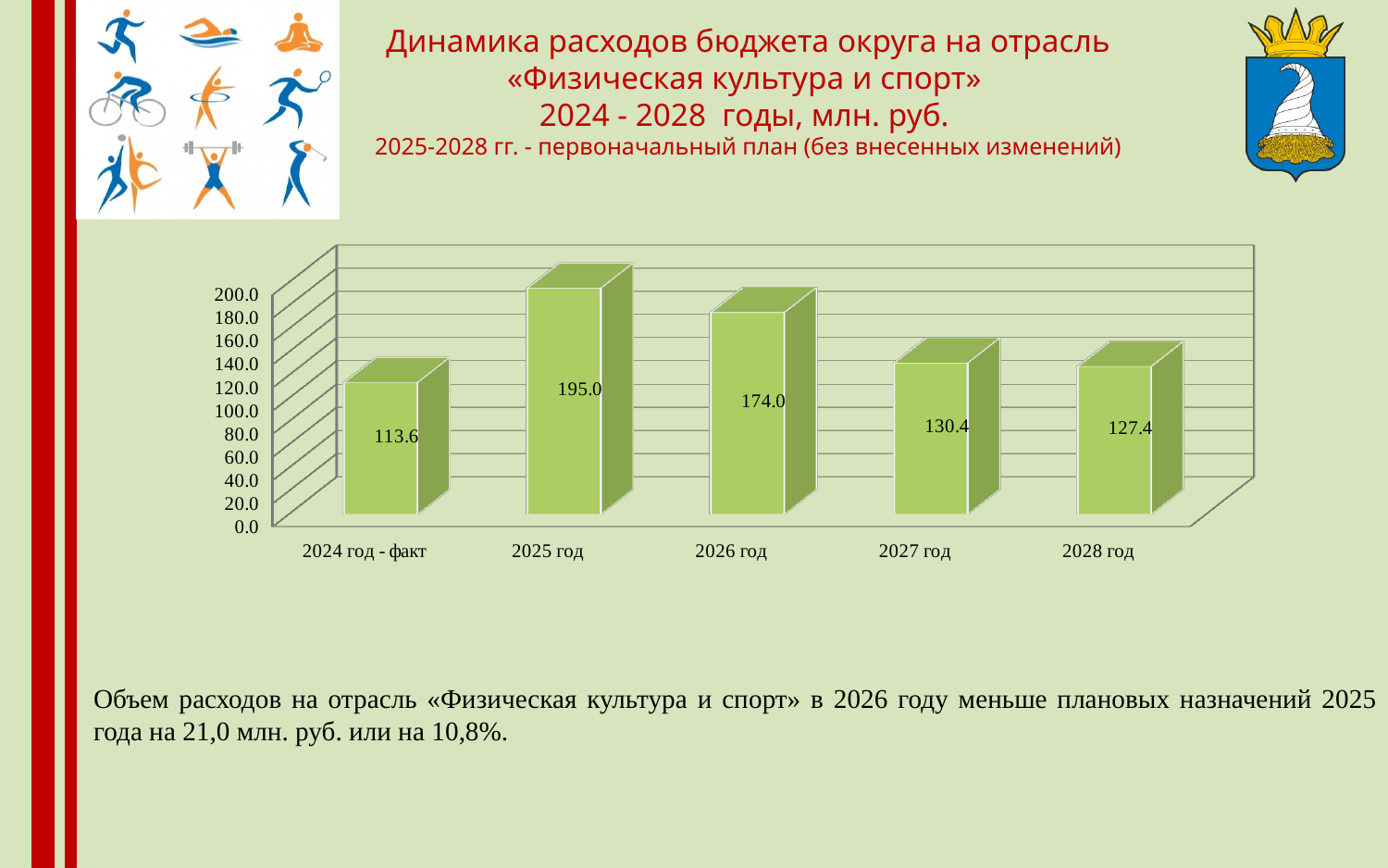
What is the difference between the values for 2025 год and 2026 год? 21.0 What is the value for 2024 год - факт? 113.6 Which is larger, the value for 2027 год or the value for 2028 год? 2027 год What is the value for 2025 год? 195.0 What kind of chart is shown on the slide? bar chart Which year has the highest value? 2025 год Which year has the lowest value? 2024 год - факт Is the value for 2026 год greater or less than 160.0? greater What is the difference between the values for 2027 год and 2028 год? 3.0 What is the value for 2028 год? 127.4 Do the values rise or fall from 2025 год to 2028 год? fall How many categories (years) are shown on the chart? 5